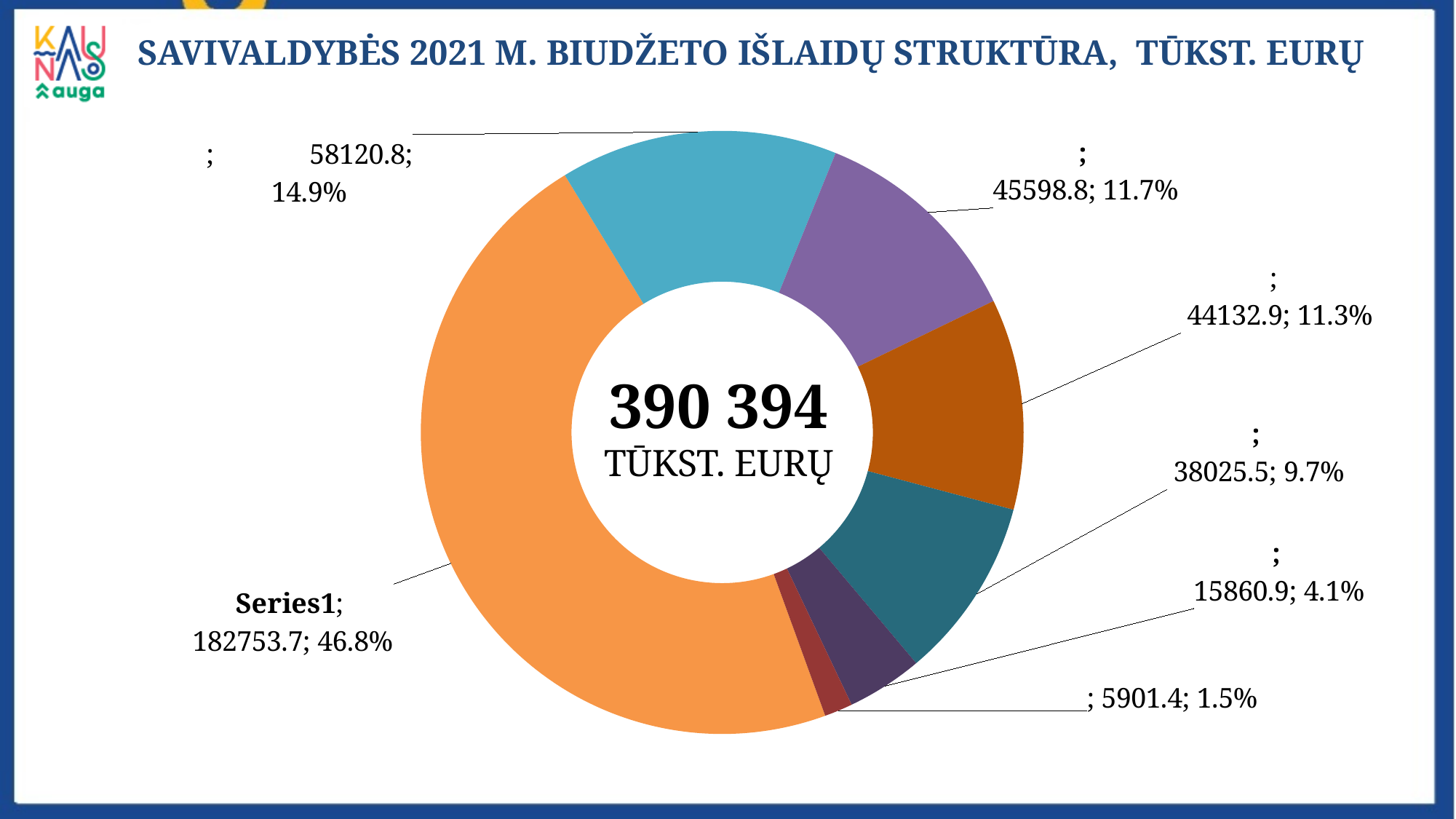
What total value is printed in the centre of the doughnut chart? 390 394 TŪKST. EURŲ What is the value of the largest slice (the orange one labelled Series1)? 182753.7 What percentage share does the purple slice with value 45598.8 have? 11.7% What is the value of the light blue (teal) slice at the top of the chart? 58120.8 What is the title of the chart on the slide? SAVIVALDYBĖS 2021 M. BIUDŽETO IŠLAIDŲ STRUKTŪRA, TŪKST. EURŲ What is the difference between the slice valued 58120.8 and the slice valued 45598.8? 12522.0 Which is larger: the slice with 11.3% share or the slice with 9.7% share? The slice with 11.3% (44132.9) What is the value of the smallest slice (the dark red one)? 5901.4 What percentage share does the smallest slice (dark red) have? 1.5% How many slices does the doughnut chart have? 7 What share of the total does the largest slice (orange, Series1) represent? 46.8% What kind of chart is shown on the slide? Doughnut (pie) chart